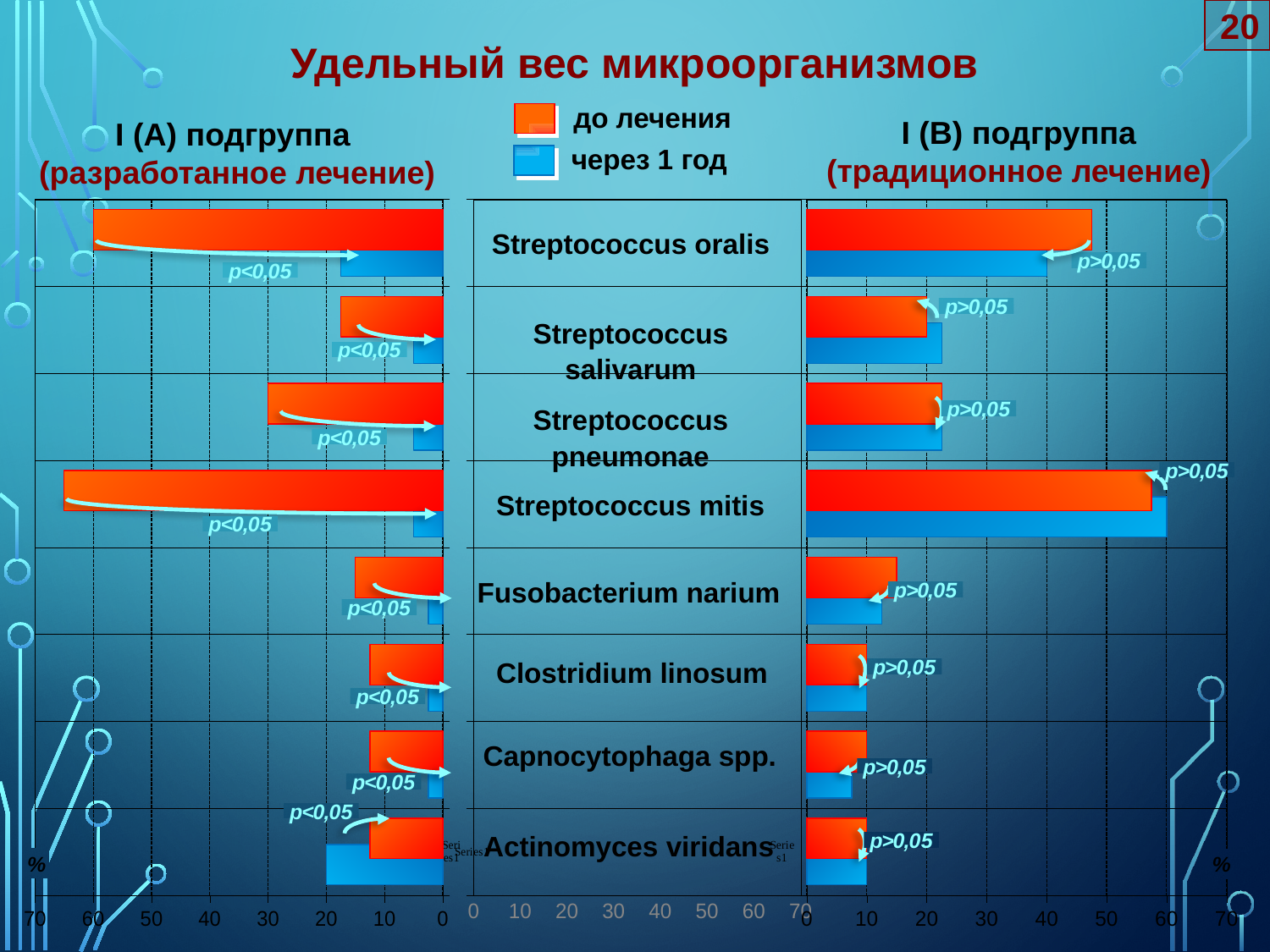
In the I (A) подгруппа chart, is the value for Streptococcus oralis до лечения greater or less than 50? greater What is the title of the slide's charts? Удельный вес микроорганизмов How many series does the legend list? 2 In the I (B) подгруппа chart, is the value for Streptococcus mitis через 1 год greater or less than 50? greater In the I (B) подгруппа chart, which microorganism has the highest value for через 1 год? Streptococcus mitis In the I (A) подгруппа chart, which microorganism has the highest value for до лечения? Streptococcus mitis In the I (B) подгруппа chart, is the value for Capnocytophaga spp. через 1 год greater or less than 10? less What kind of chart is used for the I (A) подгруппа (разработанное лечение) data? bar chart In the I (A) подгруппа chart, which is larger for Streptococcus oralis: до лечения or через 1 год? до лечения In the I (A) подгруппа chart, which is larger for Actinomyces viridans: до лечения or через 1 год? через 1 год What are the two series named in the legend? до лечения, через 1 год How many microorganism categories are shown on the slide's charts? 8